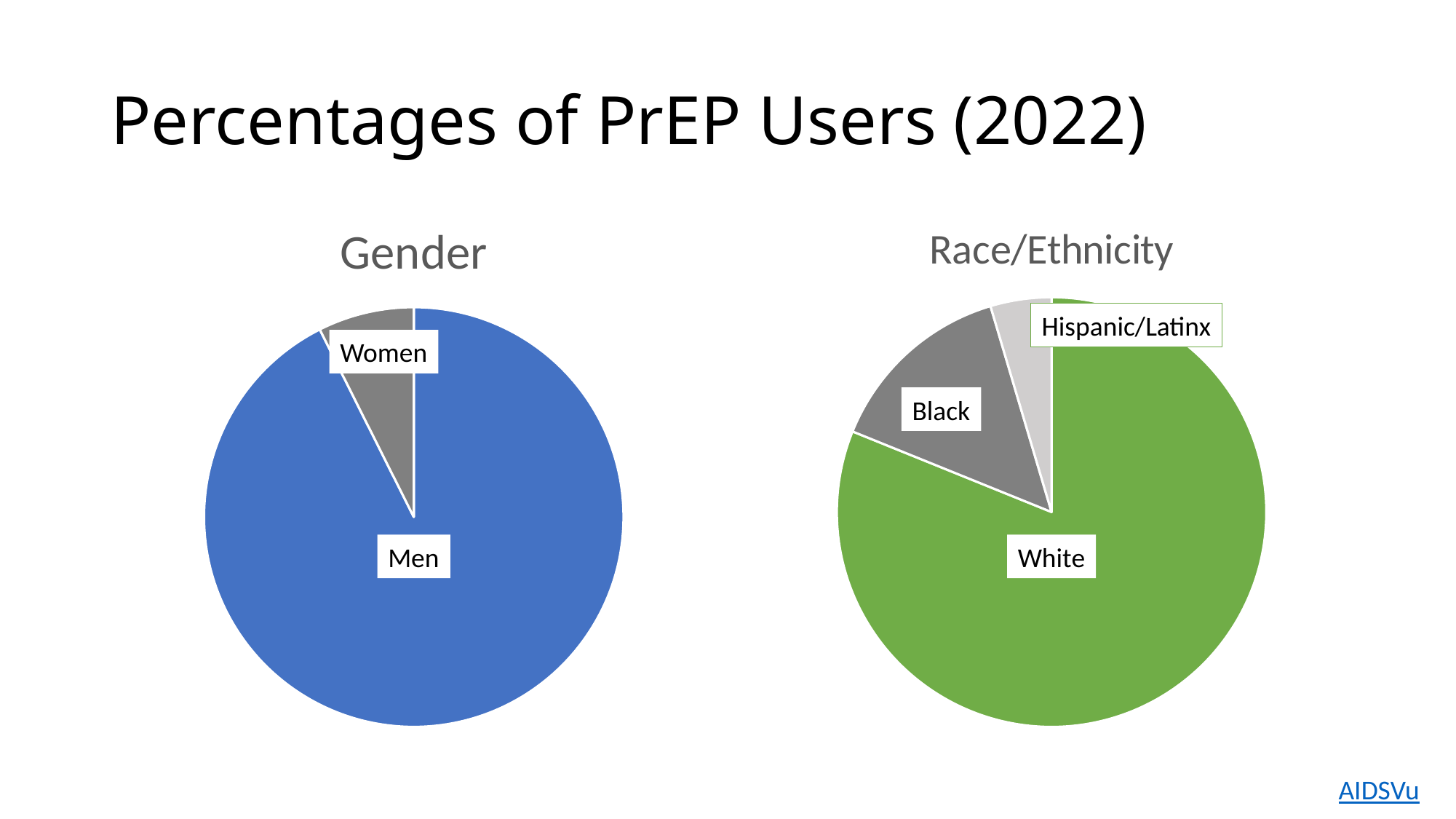
What is the title of the slide containing the two pie charts? Percentages of PrEP Users (2022) In the Race/Ethnicity chart, which slice is larger, Black or Hispanic/Latinx? Black In the Race/Ethnicity chart, which category has the largest share? White How many labeled slices does the Race/Ethnicity chart have? 3 In the Gender chart, which category has the largest share? Men In the Gender chart, which labeled category has the smallest share? Women In the Race/Ethnicity chart, what colour is the White slice? Green What kind of chart is the Race/Ethnicity chart? Pie chart In the Gender chart, which slice is larger, Men or Women? Men In the Race/Ethnicity chart, which labeled category has the smallest share? Hispanic/Latinx What kind of chart is the Gender chart? Pie chart